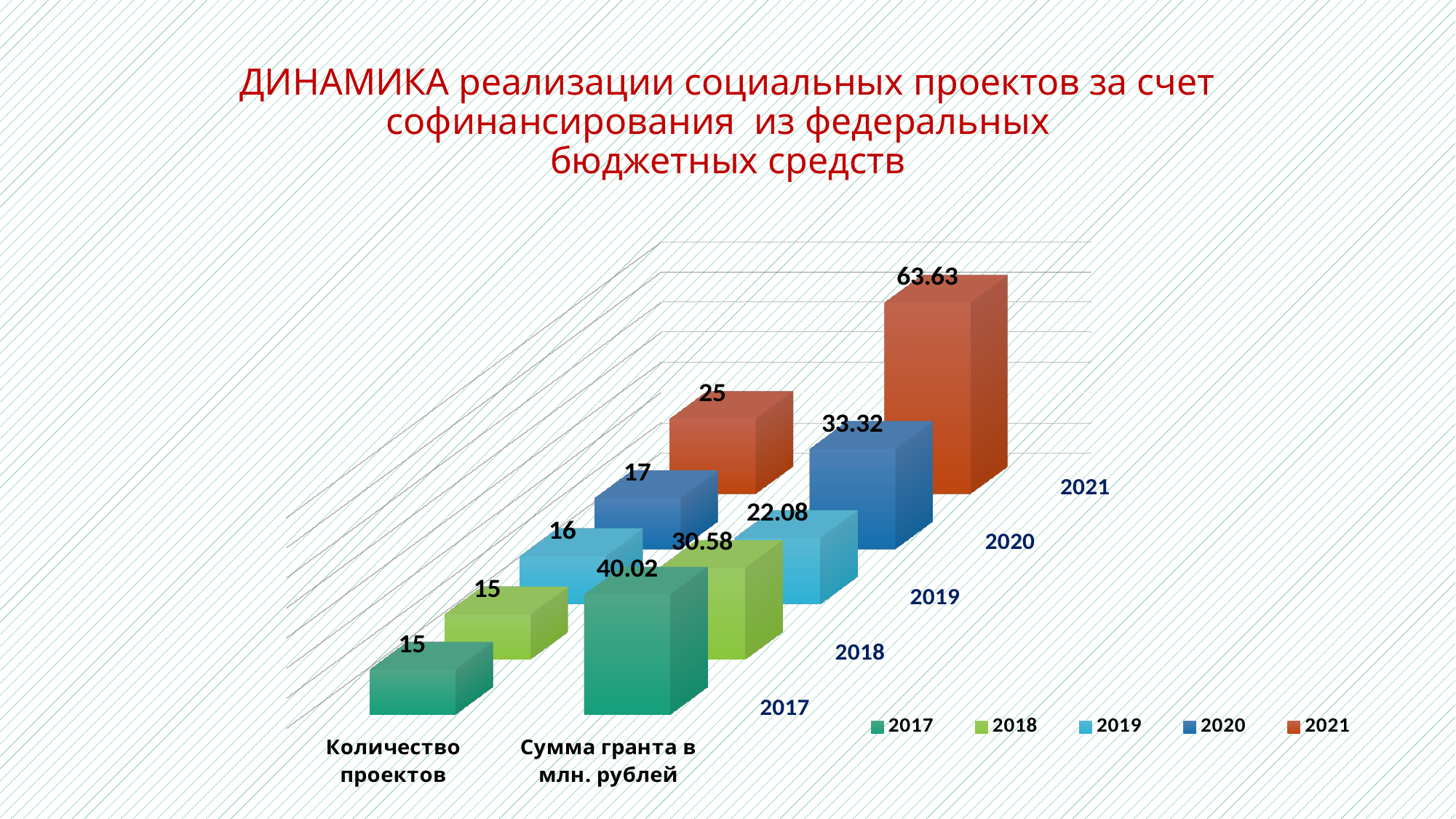
Which year has the highest value for Сумма гранта в млн. рублей? 2021 What is the value for Сумма гранта в млн. рублей in 2019? 22.08 How many series does the legend list? 5 Which year has the lowest value for Сумма гранта в млн. рублей? 2019 Which is larger for Сумма гранта в млн. рублей: the 2017 value or the 2018 value? 2017 How many categories are shown on the x axis? 2 What is the difference between the 2021 and 2020 values for Количество проектов? 8 What is the value for Количество проектов in 2021? 25 What is the value for Сумма гранта в млн. рублей in 2017? 40.02 Which series is shown in red in the legend? 2021 What is the difference between the 2021 and 2020 values for Сумма гранта в млн. рублей? 30.31 What kind of chart is shown on the slide? bar chart